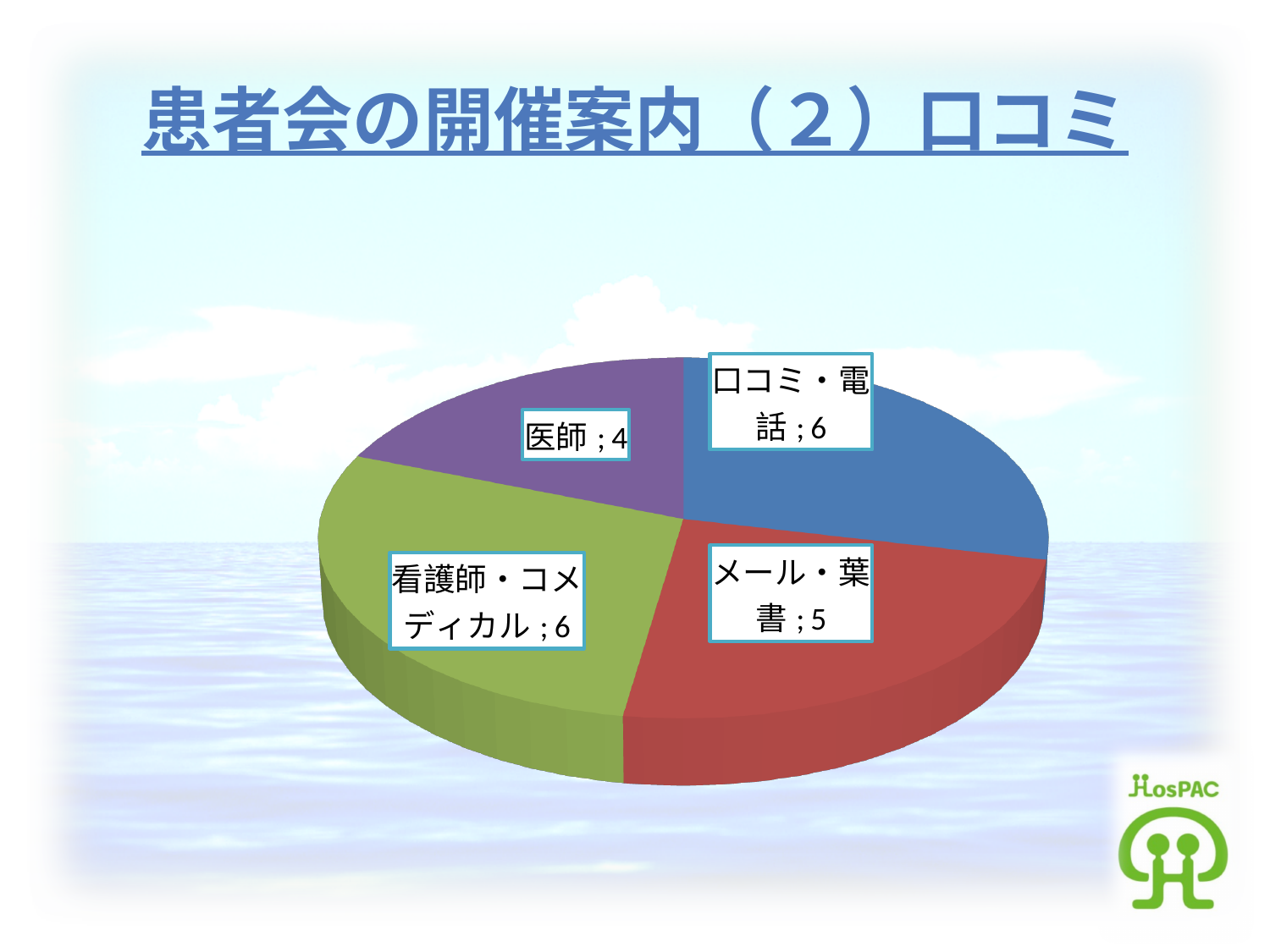
What is the value for 口コミ・電話 in the pie chart? 6 How many slices does the pie chart have? 4 What is the value for メール・葉書 in the pie chart? 5 Which category has the smallest slice in the pie chart? 医師 What kind of chart is shown on the slide? Pie chart What is the difference between the values for 口コミ・電話 and 医師? 2 What is the total of all the slices in the pie chart? 21 Which is larger, the value for 口コミ・電話 or the value for メール・葉書? 口コミ・電話 What is the difference between the values for メール・葉書 and 医師? 1 What is the value for 看護師・コメディカル in the pie chart? 6 What is the value for 医師 in the pie chart? 4 What is the title of the slide containing the pie chart? 患者会の開催案内（2）口コミ